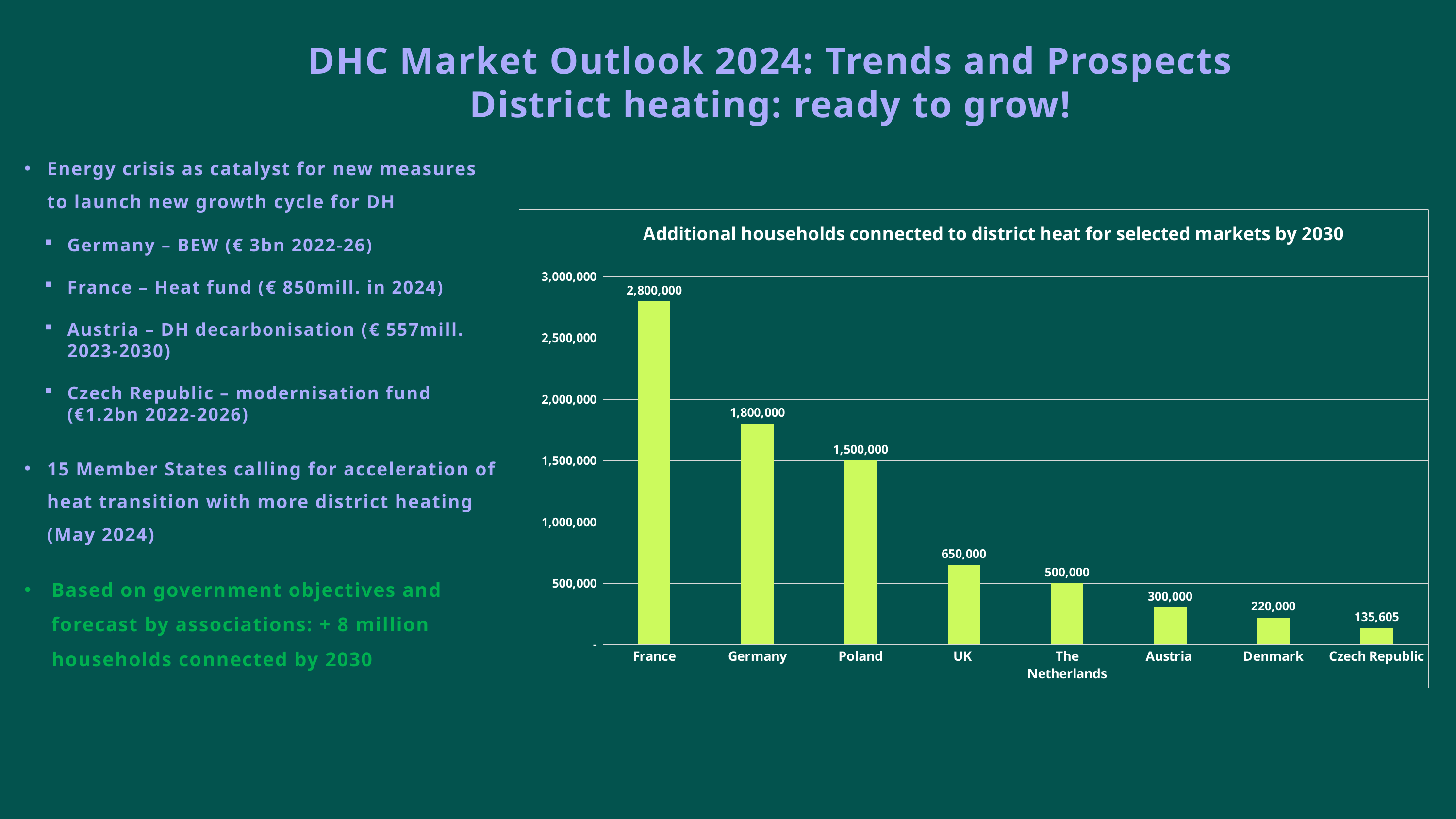
What is the title of the chart? Additional households connected to district heat for selected markets by 2030 Which is larger, the value for Denmark or the value for Austria? Austria Is the value for Poland greater or less than 1,000,000? greater Which country has the highest value? France What kind of chart is shown on the slide? bar chart How many countries are shown in the chart? 8 What is the value for Czech Republic? 135,605 What is the value for The Netherlands? 500,000 What is the difference between the values for UK and Austria? 350,000 Which country has the lowest value? Czech Republic What is the value for France? 2,800,000 What is the difference between the values for Germany and Poland? 300,000